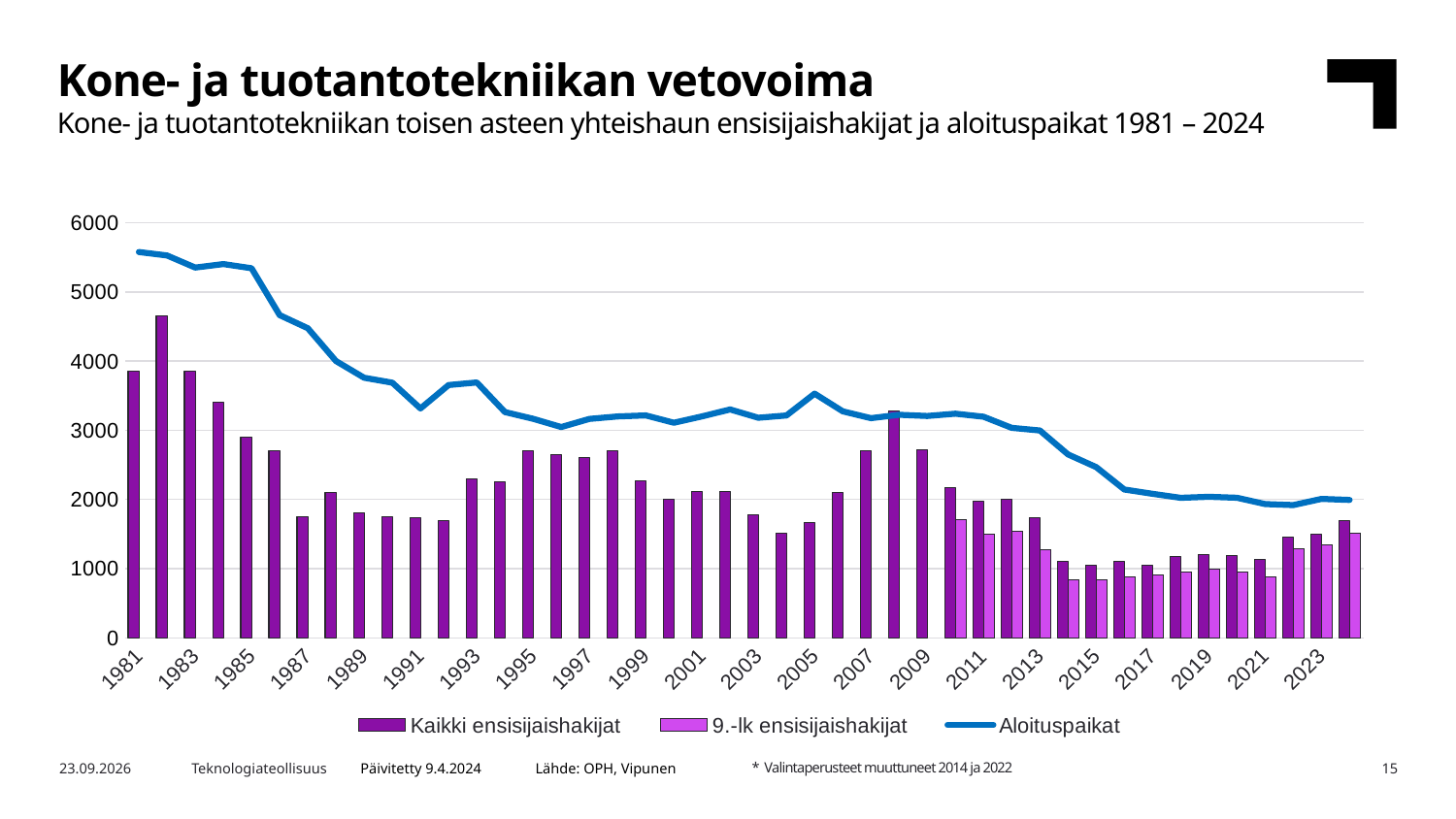
Which is larger for Kaikki ensisijaishakijat: the value in 2008 or in 2009? 2008 Is the value for Kaikki ensisijaishakijat in 1982 greater or less than 4000? greater How many years (categories) does the chart cover, from 1981 to 2024? 44 Is the value for Aloituspaikat in 2015 greater or less than 2000? greater Does the Aloituspaikat line overall rise or fall from 1981 to 2024? Fall Which is larger for Aloituspaikat: the value in 1981 or in 2024? 1981 Is the value for Aloituspaikat in 1981 greater or less than 5000? greater What is the title of the chart slide? Kone- ja tuotantotekniikan vetovoima What kind of chart is shown on the slide? A combined bar and line chart How many series does the legend list? 3 Which year has the highest value for Kaikki ensisijaishakijat? 1982